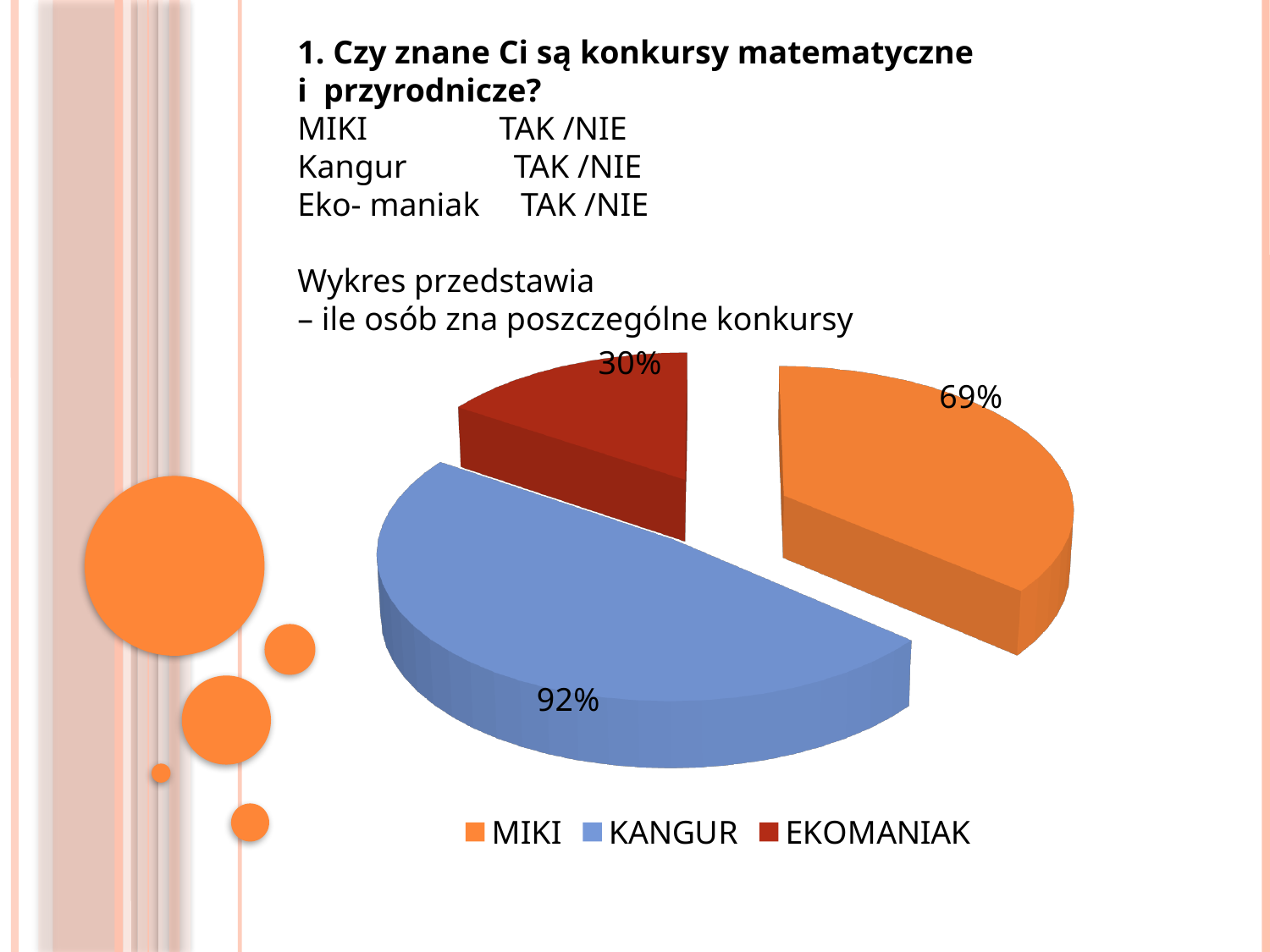
How many slices does the pie chart have? 3 Which is larger, the value for MIKI or the value for EKOMANIAK? MIKI What value is shown for the EKOMANIAK slice? 30% What is the difference between the values for MIKI and EKOMANIAK? 39% What value is shown for the KANGUR slice? 92% What value is shown for the MIKI slice? 69% What colour is the KANGUR slice in the pie chart? blue How many entries does the legend list? 3 Which category has the highest value in the pie chart? KANGUR Which category has the lowest value in the pie chart? EKOMANIAK What kind of chart is shown on the slide? pie chart What is the difference between the values for KANGUR and MIKI? 23%